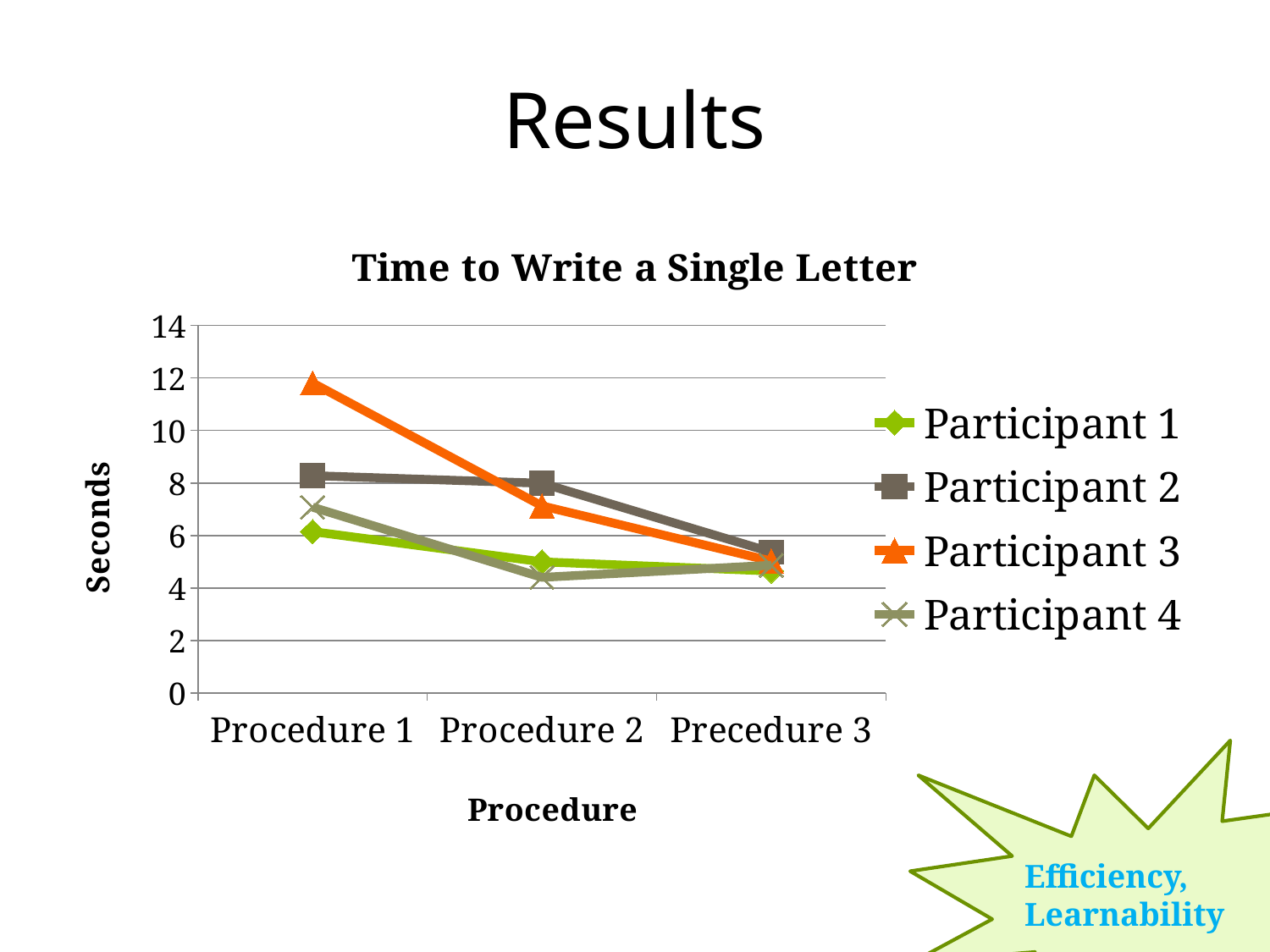
Which participant has the lowest value at Procedure 2? Participant 4 What kind of chart is shown on the slide? Line chart How many series does the legend list? 4 How many procedures are shown on the x axis? 3 Which participant has the highest value at Procedure 1? Participant 3 What is the label of the vertical axis? Seconds Which participant has the lowest value at Procedure 1? Participant 1 Do the values for Participant 3 rise or fall from Procedure 1 to Precedure 3? fall Is the value for Participant 3 at Procedure 1 greater or less than 10? greater Which participant has the highest value at Procedure 2? Participant 2 What is the title of the chart? Time to Write a Single Letter Is the value for Participant 1 at Procedure 2 greater or less than 6? less